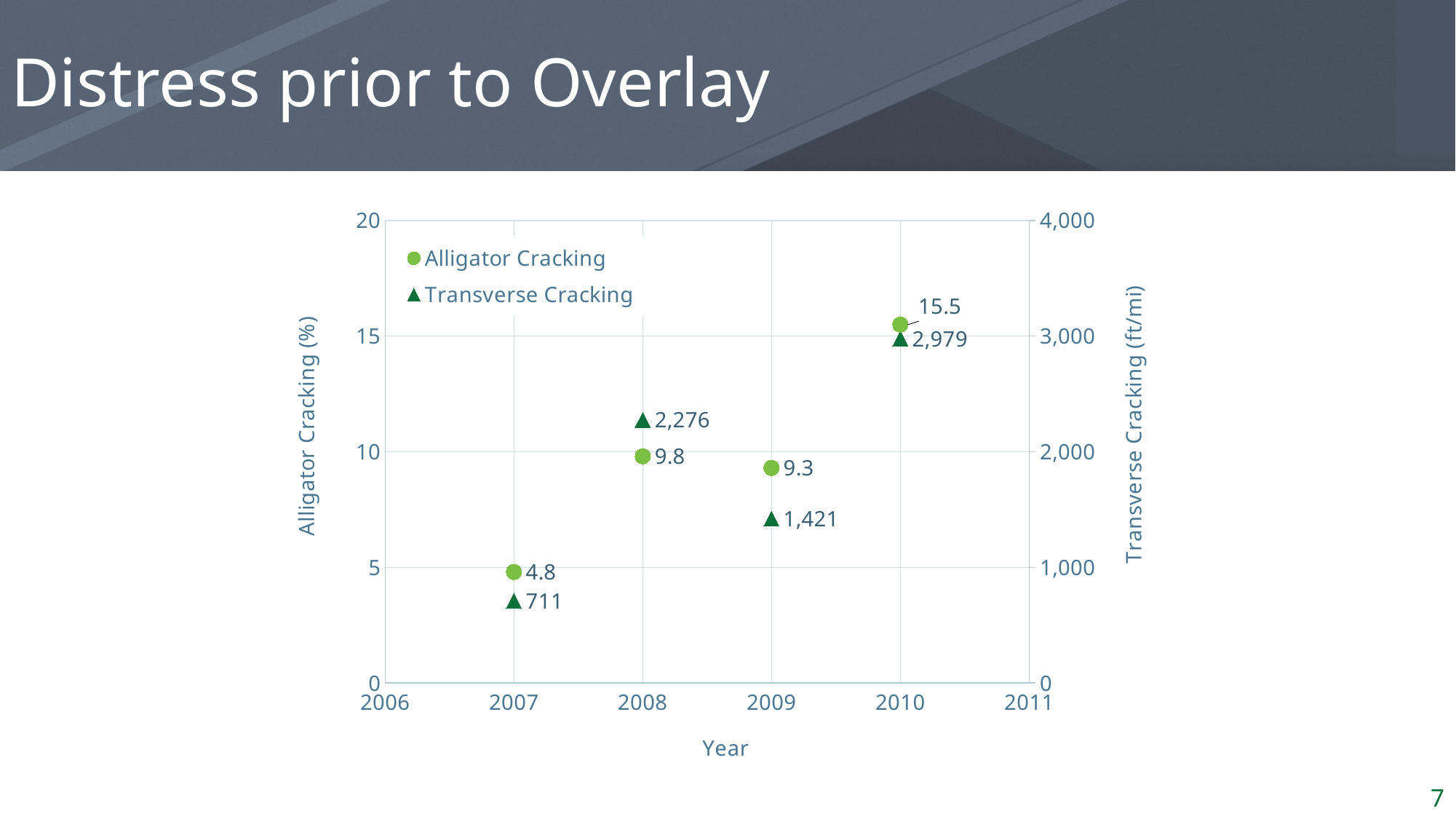
What is the Transverse Cracking value for 2008? 2,276 Which year has the lowest Transverse Cracking value? 2007 Which year has the highest Alligator Cracking value? 2010 Which is larger, the Transverse Cracking value for 2008 or for 2009? 2008 What is the difference between the Transverse Cracking values for 2008 and 2009? 855 What is the Alligator Cracking value for 2009? 9.3 How many series does the legend list? 2 How many data points are plotted for Alligator Cracking? 4 What is the Transverse Cracking value for 2010? 2,979 What is the Alligator Cracking value for 2007? 4.8 What is the difference between the Alligator Cracking values for 2010 and 2007? 10.7 What is the label of the right-hand vertical axis? Transverse Cracking (ft/mi)